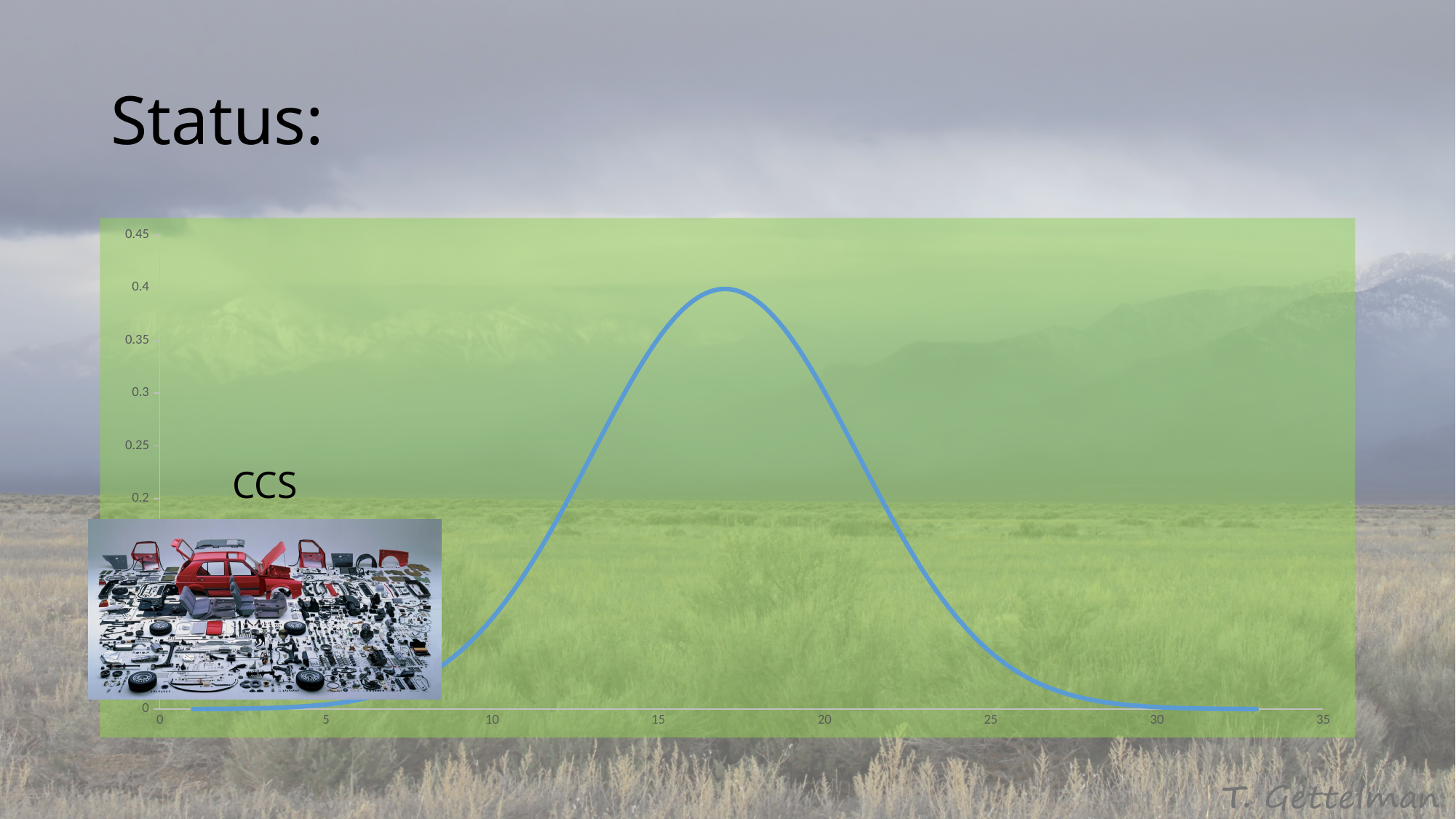
Does the curve rise or fall between x = 20 and x = 30? fall What kind of chart is shown on the slide? line chart What is the highest value labelled on the x axis? 35 Is the value of the curve at x = 30 greater or less than 0.05? less Is the peak value of the curve greater or less than 0.35? greater Does the curve rise or fall between x = 5 and x = 15? rise Is the value of the curve at x = 25 greater or less than 0.1? less What is the highest value labelled on the y axis? 0.45 Between which two labelled x-axis ticks does the curve reach its highest point? 15 and 20